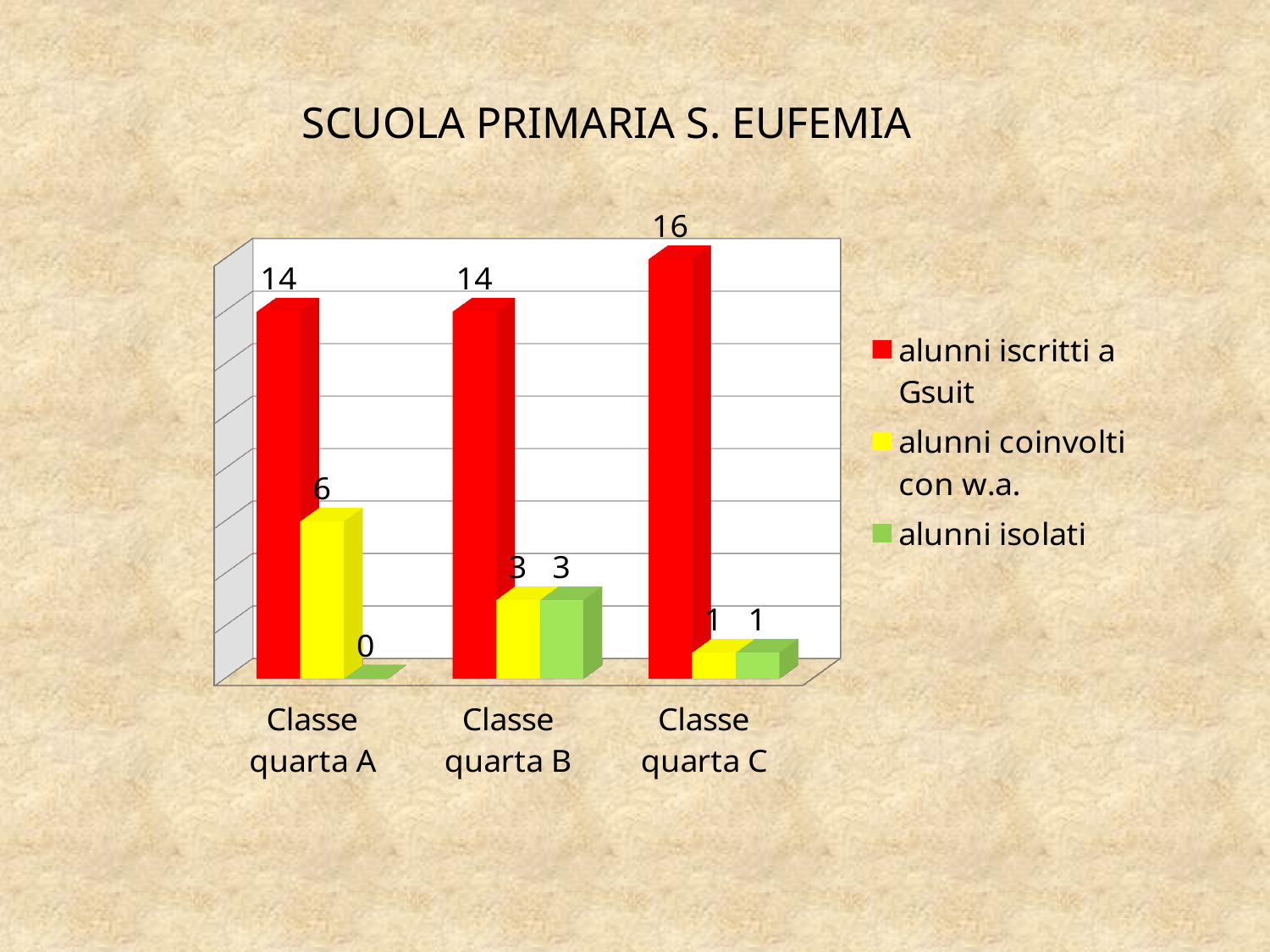
Which class has the highest value for 'alunni iscritti a Gsuit'? Classe quarta C What is the value for 'alunni isolati' in Classe quarta A? 0 How many series does the legend list? 3 What is the difference between 'alunni iscritti a Gsuit' and 'alunni coinvolti con w.a.' in Classe quarta A? 8 Which class has the lowest value for 'alunni coinvolti con w.a.'? Classe quarta C How many classes are shown on the x axis? 3 What is the value for 'alunni coinvolti con w.a.' in Classe quarta A? 6 What is the title of the slide? SCUOLA PRIMARIA S. EUFEMIA What is the value for 'alunni isolati' in Classe quarta B? 3 Which is larger: 'alunni coinvolti con w.a.' in Classe quarta A or in Classe quarta B? Classe quarta A What is the value for 'alunni iscritti a Gsuit' in Classe quarta C? 16 What kind of chart is shown on the slide? Bar chart